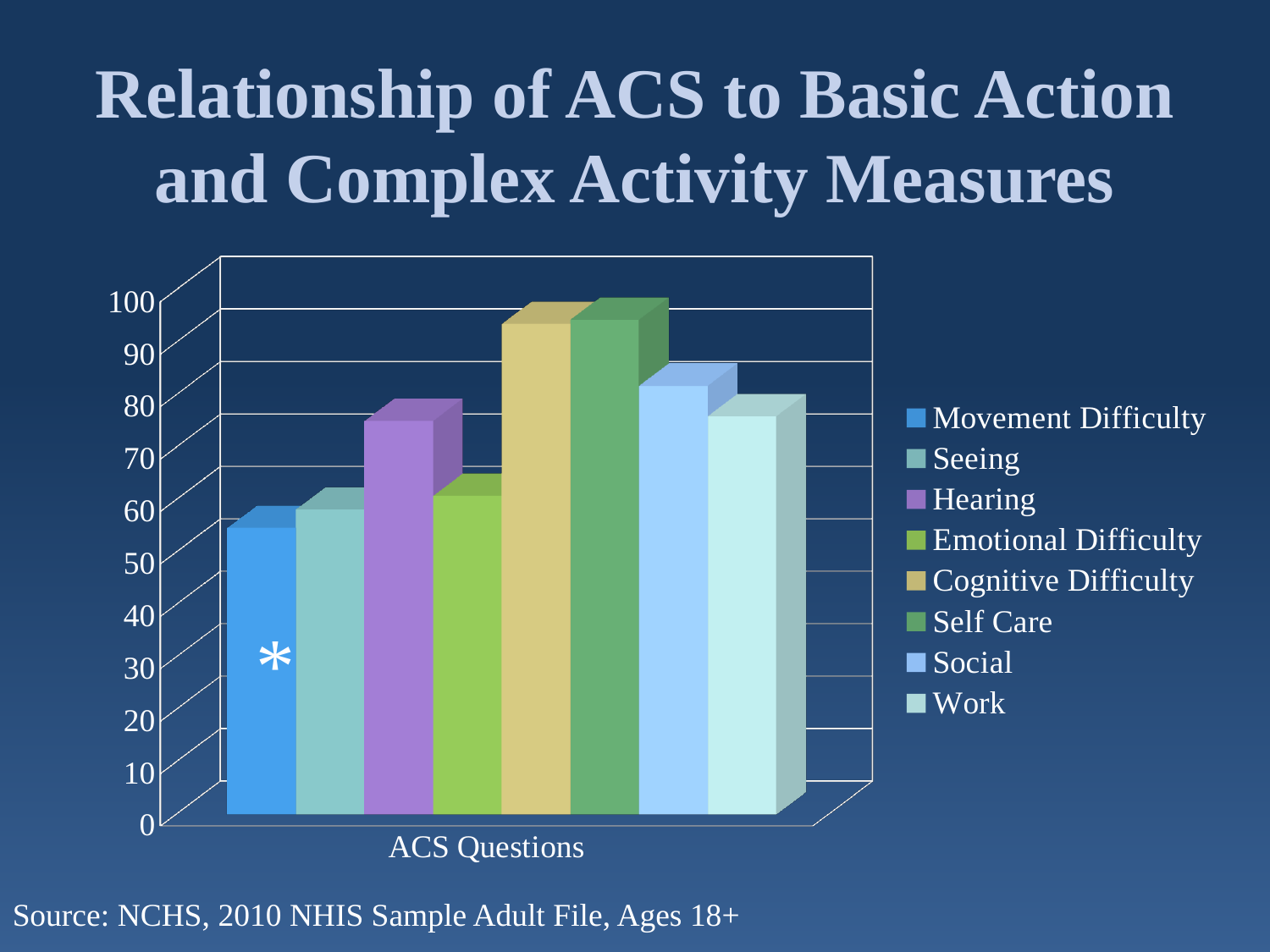
Is the value for Movement Difficulty greater or less than 50? greater Which is larger, the value for Social or the value for Work? Social Which series has the lowest bar? Movement Difficulty Is the value for Emotional Difficulty greater or less than 70? less Is the value for Cognitive Difficulty greater or less than 90? greater How many bars are plotted in the chart? 8 What kind of chart is shown on the slide? bar chart Which is larger, the value for Hearing or the value for Seeing? Hearing How many series does the legend list? 8 Which bar is marked with an asterisk? Movement Difficulty What is the label on the x axis of the chart? ACS Questions